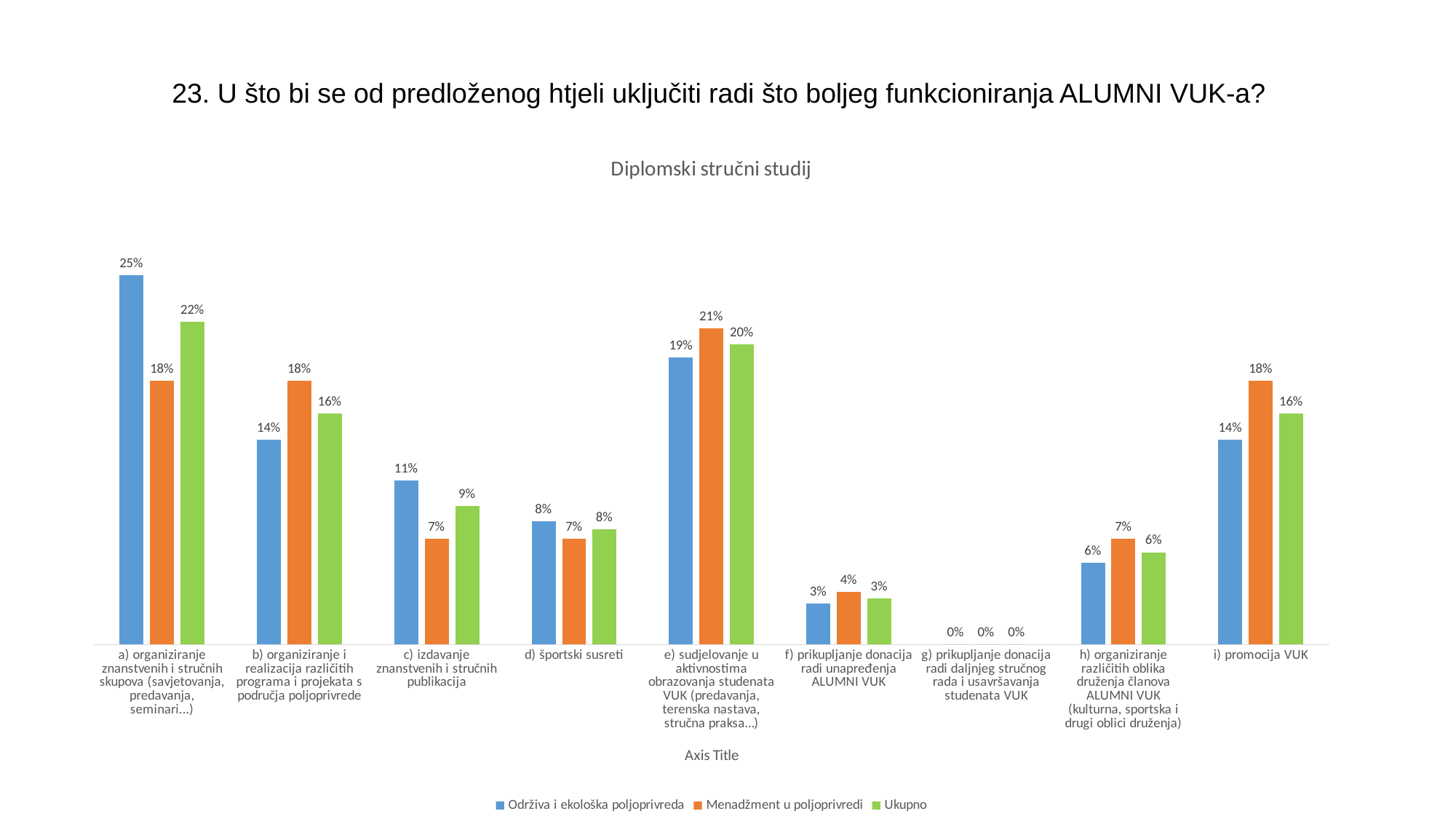
What is the value of the Ukupno series for category a) organiziranje znanstvenih i stručnih skupova? 22% What is the title of the chart? Diplomski stručni studij Which category has the lowest value in the Ukupno series? g) prikupljanje donacija radi daljnjeg stručnog rada i usavršavanja studenata VUK For category c) izdavanje znanstvenih i stručnih publikacija, which series has the larger value: Održiva i ekološka poljoprivreda or Menadžment u poljoprivredi? Održiva i ekološka poljoprivreda Which category has the highest value in the Održiva i ekološka poljoprivreda series? a) organiziranje znanstvenih i stručnih skupova (savjetovanja, predavanja, seminari...) What is the value of the Menadžment u poljoprivredi series for category e) sudjelovanje u aktivnostima obrazovanja studenata VUK? 21% What is the value of the Održiva i ekološka poljoprivreda series for category i) promocija VUK? 14% What kind of chart is shown on the slide? Bar chart How many series does the legend list? 3 How many categories are shown on the x axis of the chart? 9 What is the difference between the Održiva i ekološka poljoprivreda value and the Menadžment u poljoprivredi value for category a) organiziranje znanstvenih i stručnih skupova? 7% Which series is shown in green in the chart? Ukupno